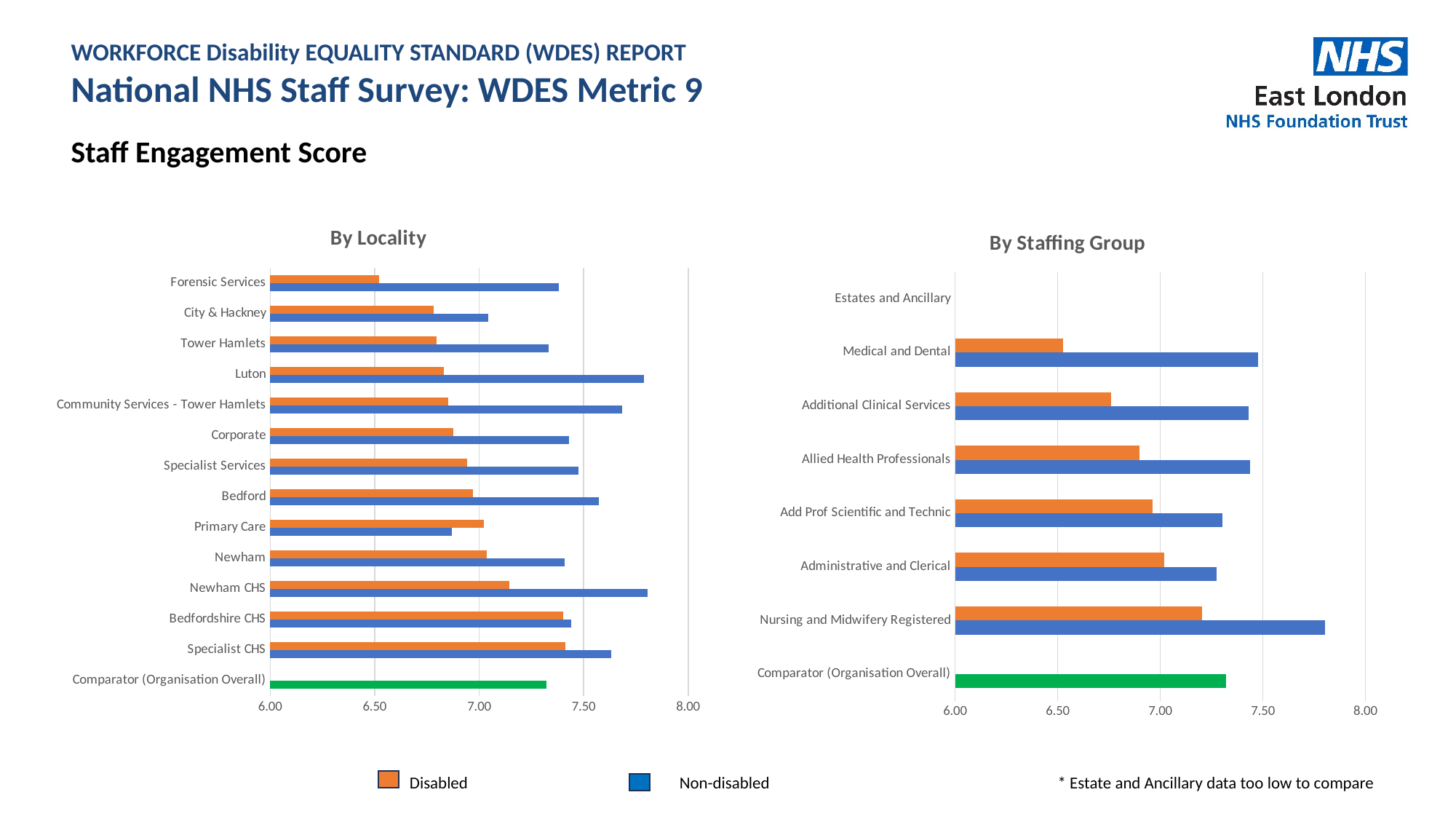
In the 'By Locality' chart, which locality has the lowest Disabled score? Forensic Services In the 'By Staffing Group' chart, which staffing group has the highest Non-disabled score? Nursing and Midwifery Registered In the 'By Staffing Group' chart, is the Disabled value for Medical and Dental greater or less than 7.00? less In the 'By Staffing Group' chart, which category has no bars plotted? Estates and Ancillary In the 'By Locality' chart, for Primary Care, which is larger: the Disabled or the Non-disabled score? Disabled In the 'By Locality' chart, is the Non-disabled value for Luton greater or less than 7.50? greater How many categories are shown on the 'By Staffing Group' chart? 8 In the 'By Staffing Group' chart, is the Non-disabled value for Nursing and Midwifery Registered greater or less than 7.50? greater How many series does the legend list? 2 What kind of chart is the 'By Locality' chart? bar chart How many categories are shown on the 'By Locality' chart? 14